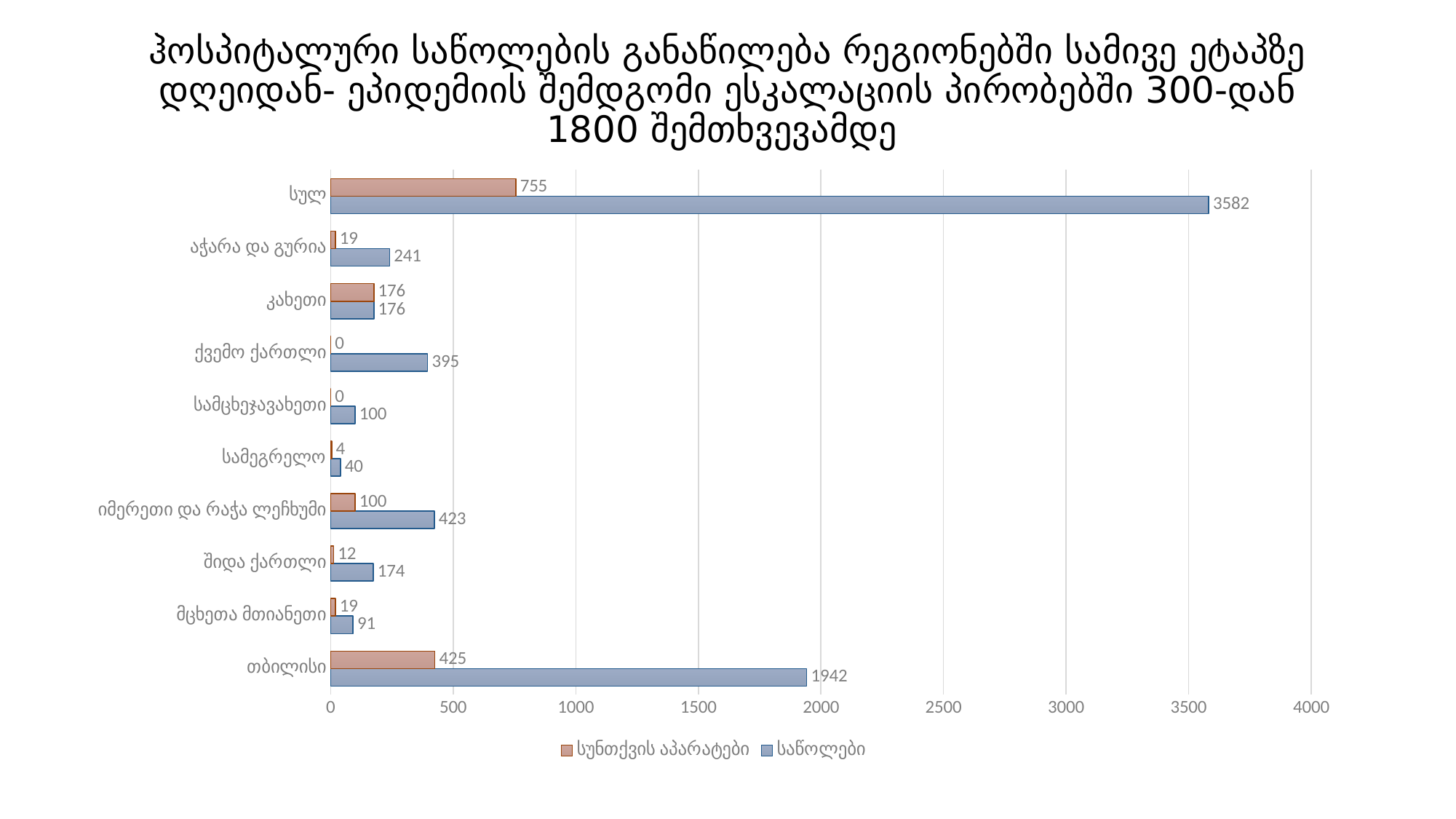
Which series is shown in blue in the legend? საწოლები What is the value of სუნთქვის აპარატები for სულ? 755 What type of chart is shown on the slide? Bar chart How many categories are shown on the vertical axis? 10 Which is larger: the საწოლები value for აჭარა და გურია or for შიდა ქართლი? აჭარა და გურია What is the value of საწოლები for ქვემო ქართლი? 395 How many series does the legend list? 2 What is the difference between the საწოლები values for თბილისი and იმერეთი და რაჭა ლეჩხუმი? 1519 What is the value of საწოლები for თბილისი? 1942 What is the value of სუნთქვის აპარატები for იმერეთი და რაჭა ლეჩხუმი? 100 Excluding the სულ row, which region has the highest value of საწოლები? თბილისი Which region has the lowest value of საწოლები? სამეგრელო